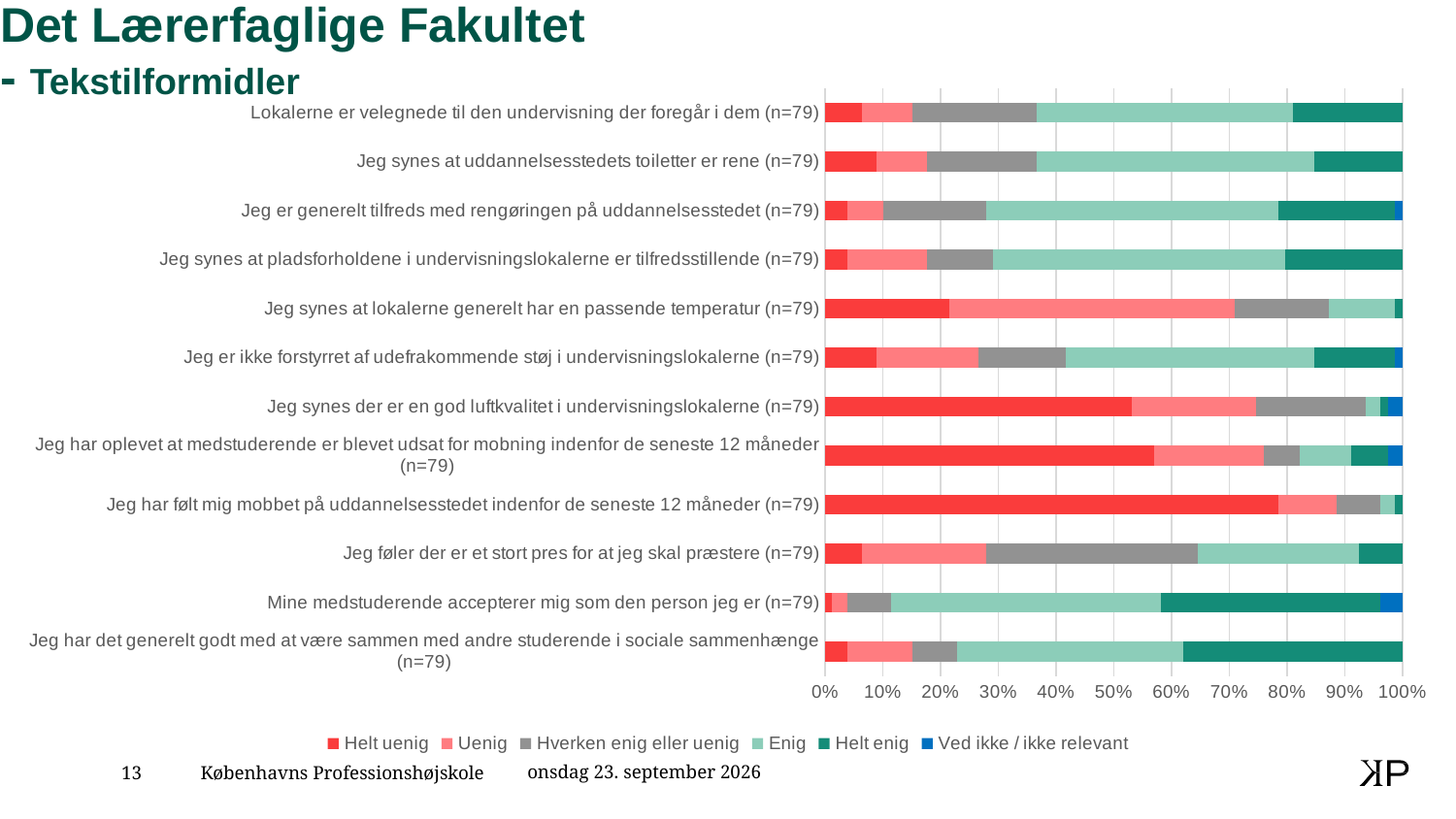
Is the 'Helt uenig' share for 'Jeg har oplevet at medstuderende er blevet udsat for mobning indenfor de seneste 12 måneder' greater or less than 50%? greater What is the sample size (n) shown for each statement? 79 Which statement has the largest 'Helt uenig' share? Jeg har følt mig mobbet på uddannelsesstedet indenfor de seneste 12 måneder (n=79) Is the 'Helt uenig' share for 'Jeg synes at lokalerne generelt har en passende temperatur' greater or less than 30%? less Is the 'Helt uenig' share for 'Jeg har følt mig mobbet på uddannelsesstedet indenfor de seneste 12 måneder' greater or less than 70%? greater Which series is shown in blue in the legend? Ved ikke / ikke relevant What does each stacked bar total? 100% How many statements (categories) are plotted in the chart? 12 How many series does the legend list? 6 Which statement has the smallest 'Helt uenig' share? Mine medstuderende accepterer mig som den person jeg er (n=79) Which has the larger 'Helt uenig' share: 'Jeg har følt mig mobbet på uddannelsesstedet indenfor de seneste 12 måneder' or 'Jeg synes der er en god luftkvalitet i undervisningslokalerne'? Jeg har følt mig mobbet på uddannelsesstedet indenfor de seneste 12 måneder What kind of chart is shown on the slide? Stacked bar chart